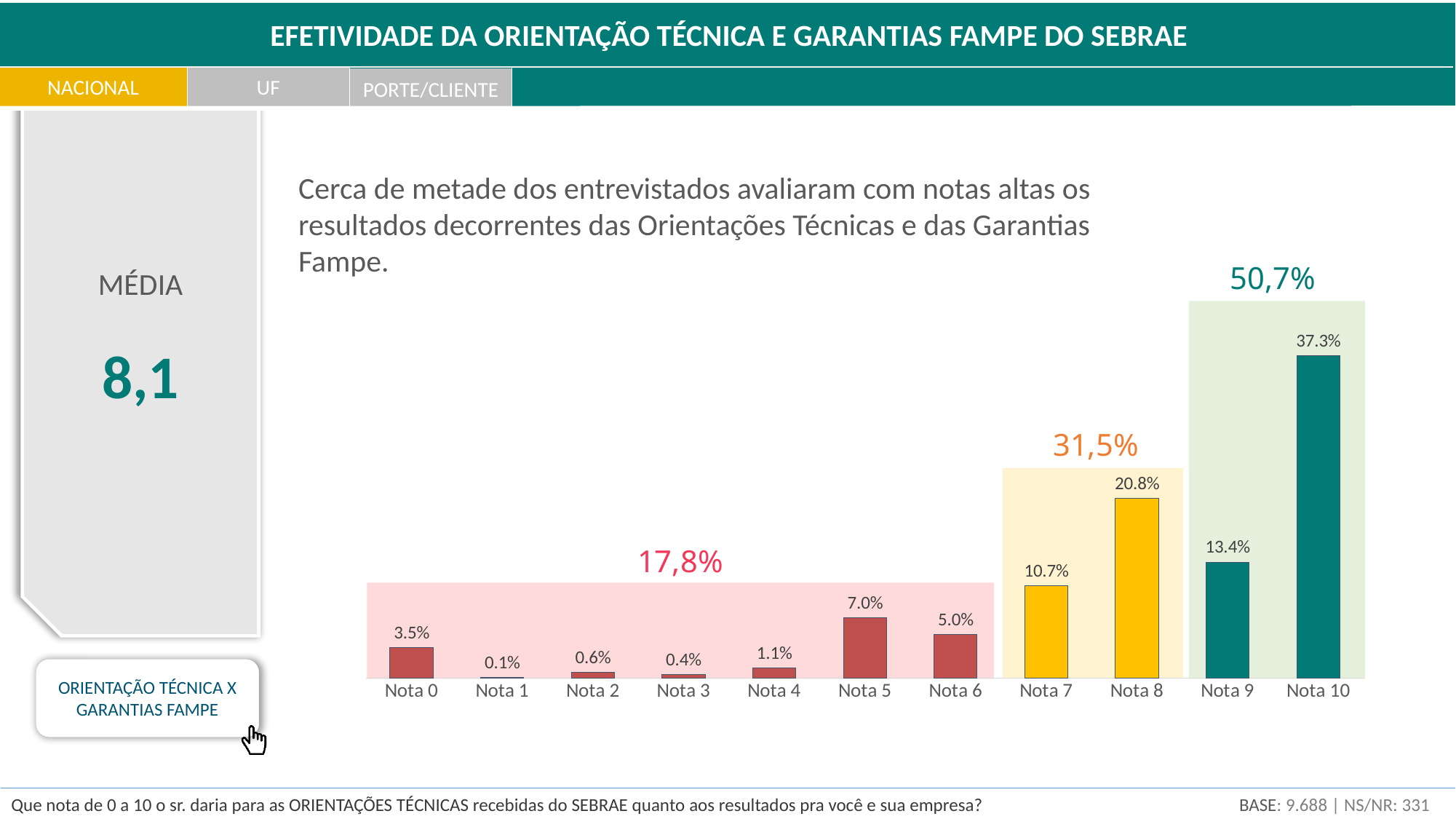
What is the average (MÉDIA) shown on the slide? 8,1 Which category has the lowest value? Nota 1 How many categories are shown on the x axis? 11 What is the value for Nota 8? 20.8% What is the value for Nota 5? 7.0% What is the combined share shown for the group Nota 0 to Nota 6? 17,8% Which category has the highest value? Nota 10 What kind of chart is shown? bar chart Which is larger, the value for Nota 7 or the value for Nota 9? Nota 9 What is the value for Nota 10? 37.3% What is the difference between the values for Nota 10 and Nota 9? 23.9% What is the combined share shown for the group Nota 9 and Nota 10? 50,7%